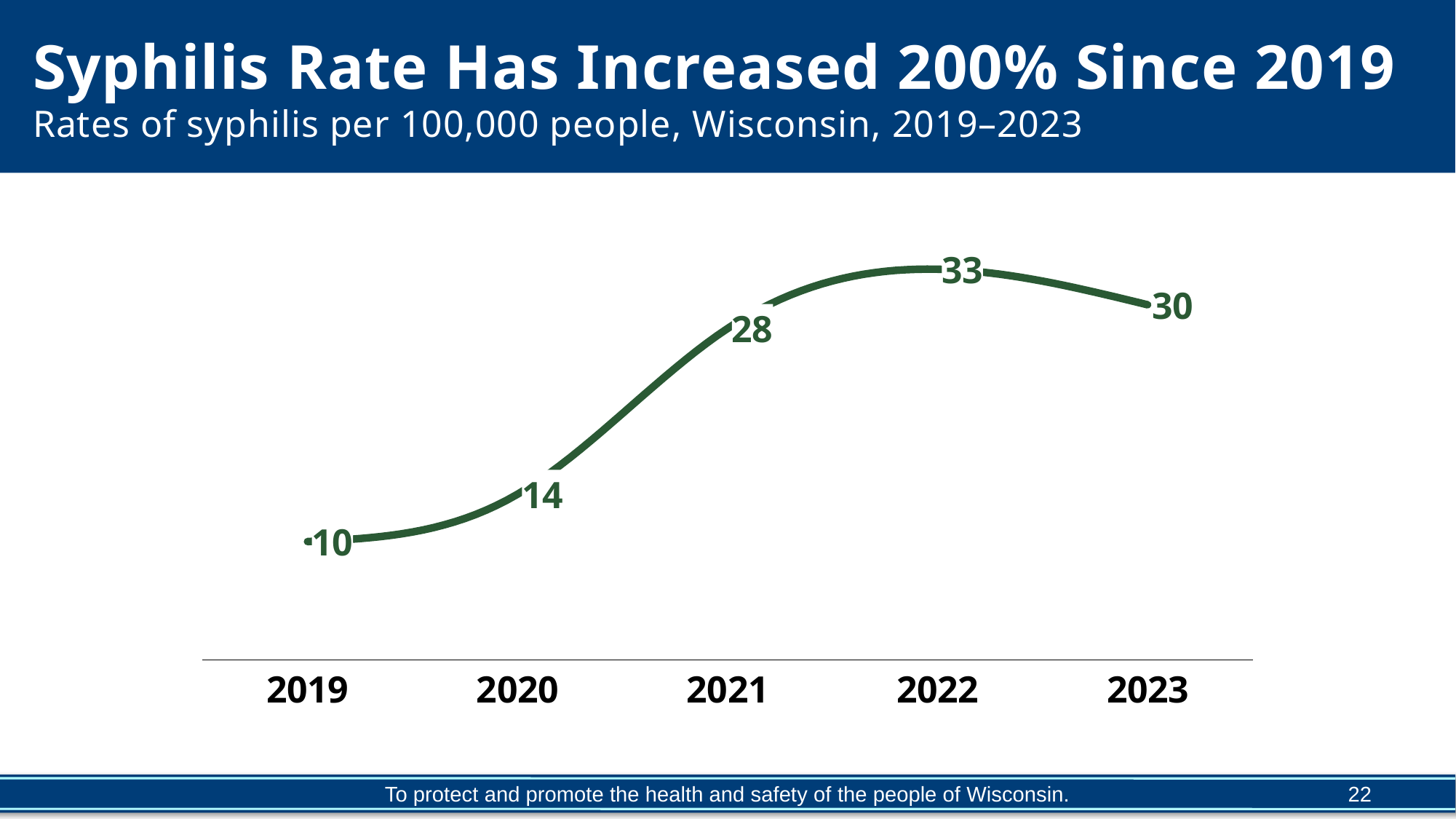
Which year had a higher syphilis rate, 2022 or 2023? 2022 Which year had the lowest syphilis rate? 2019 How many years are plotted on the chart? 5 What was the syphilis rate per 100,000 people in Wisconsin in 2019? 10 Which year had the highest syphilis rate? 2022 What kind of chart is shown on the slide? Line chart What is the title of the chart on the slide? Syphilis Rate Has Increased 200% Since 2019 What was the syphilis rate per 100,000 people in Wisconsin in 2021? 28 By how much did the syphilis rate increase from 2019 to 2022? 23 Did the syphilis rate rise or fall between 2019 and 2022? Rise What is the difference between the syphilis rate in 2020 and in 2021? 14 What was the syphilis rate per 100,000 people in Wisconsin in 2023? 30